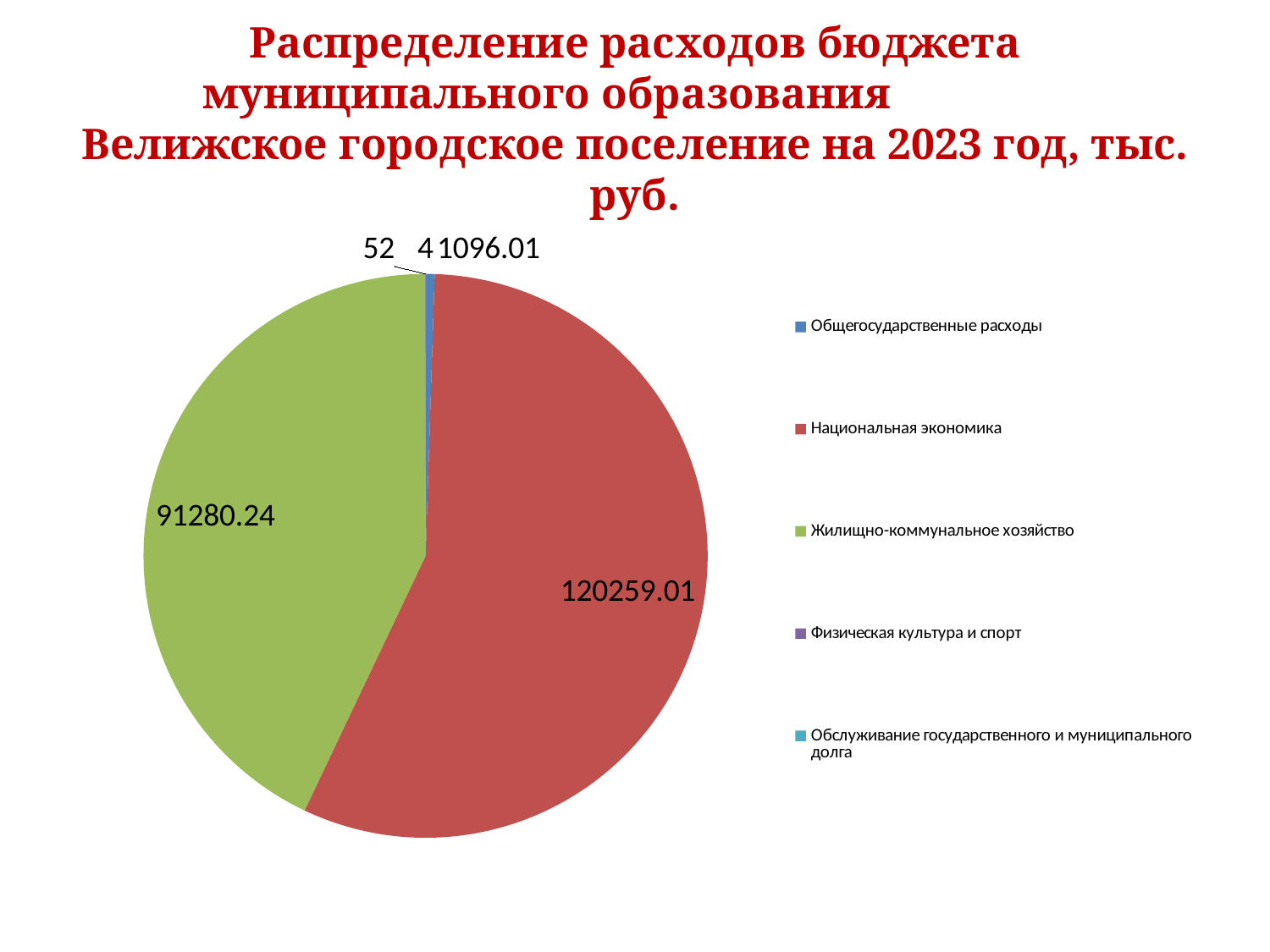
What is the total of all the values labelled on the pie chart? 212691.26 For which year does the chart title say the budget expenditures are distributed? 2023 What is the value for Общегосударственные расходы? 1096.01 What is the value for Национальная экономика? 120259.01 Which category has the largest slice of the pie? Национальная экономика What colour is the slice for Национальная экономика? Red How many categories does the legend of the pie chart list? 5 Which is larger, Жилищно-коммунальное хозяйство or Общегосударственные расходы? Жилищно-коммунальное хозяйство What is the value for Жилищно-коммунальное хозяйство? 91280.24 What is the difference between the values for Национальная экономика and Жилищно-коммунальное хозяйство? 28978.77 What kind of chart is shown on the slide? Pie chart Which is larger, Национальная экономика or Жилищно-коммунальное хозяйство? Национальная экономика